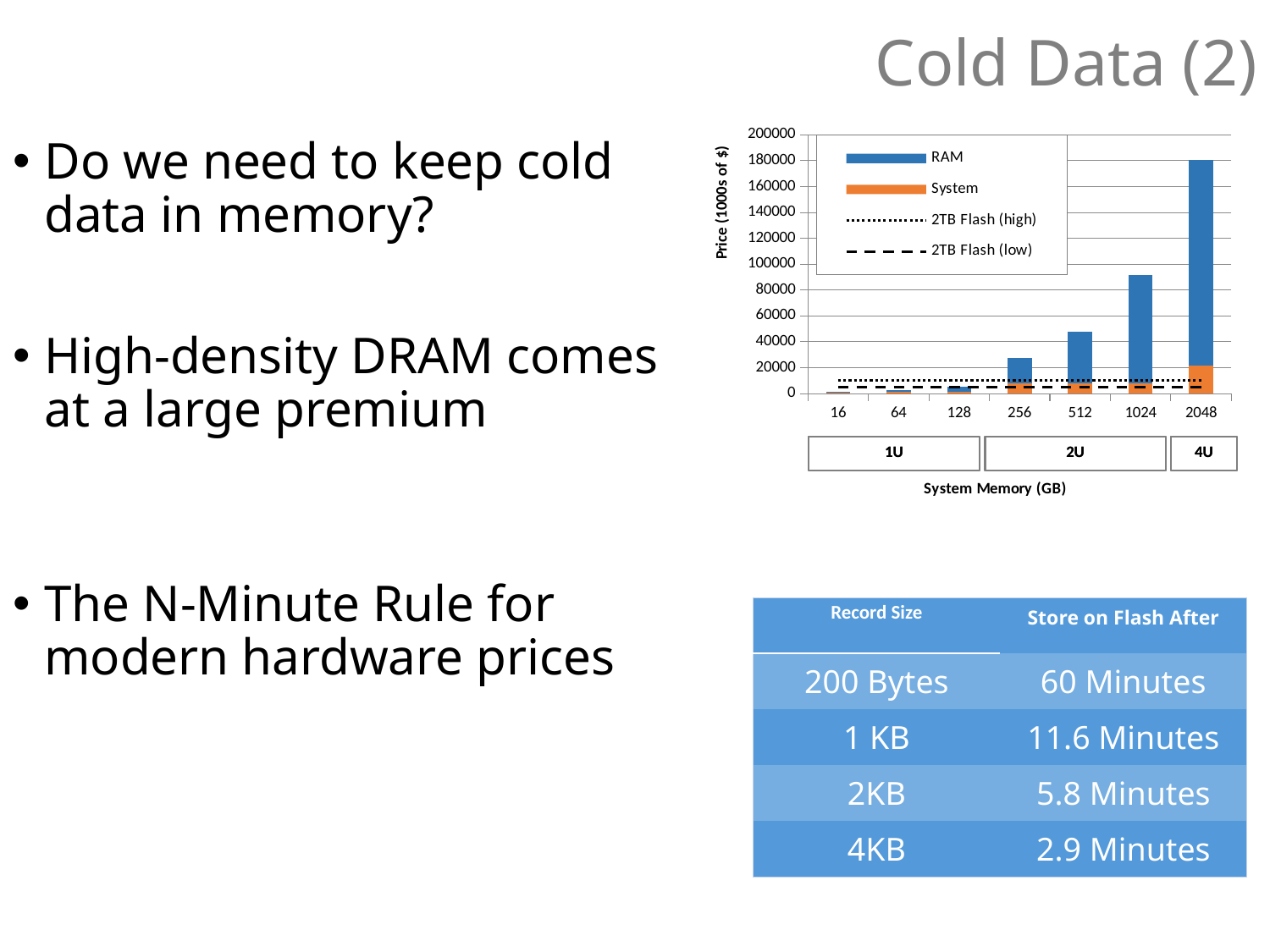
Which system memory size has the lowest total price in the chart? 16 What kind of chart is shown on the slide? combination bar and line chart Is the total price for 512 GB greater or less than 60000? less Do the total prices rise or fall as system memory increases along the x axis? rise Is the total price for 2048 GB greater or less than 160000? greater Which has the larger total price, 1024 GB or 512 GB? 1024 Is the total price for 1024 GB greater or less than 80000? greater Which system memory size has the highest total price in the chart? 2048 How many entries does the chart's legend list? 4 How many system memory categories are shown on the x axis of the chart? 7 What is the title of the chart's y axis? Price (1000s of $)